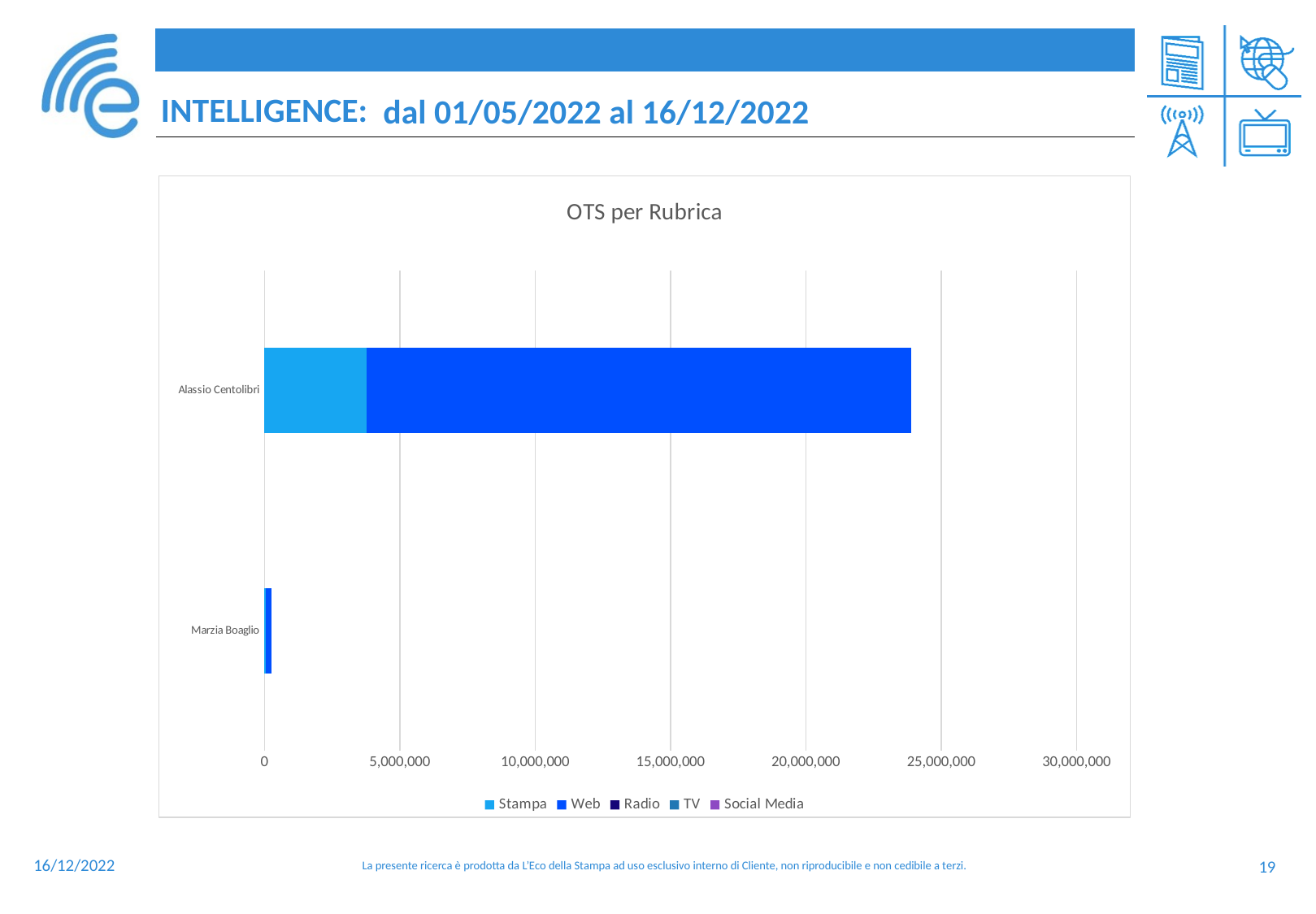
What is the title of the chart? OTS per Rubrica Is the total value for Marzia Boaglio greater or less than 5,000,000? less How many series does the chart legend list? 5 How many categories (rubriche) are shown on the chart? 2 Is the total value for Alassio Centolibri greater or less than 25,000,000? less Is the total value for Alassio Centolibri greater or less than 20,000,000? greater Which has a larger total OTS, Alassio Centolibri or Marzia Boaglio? Alassio Centolibri Which category has the lowest total OTS? Marzia Boaglio What kind of chart is shown on the slide? bar chart Which series makes up the larger part of the Alassio Centolibri bar, Stampa or Web? Web Which category has the highest total OTS? Alassio Centolibri